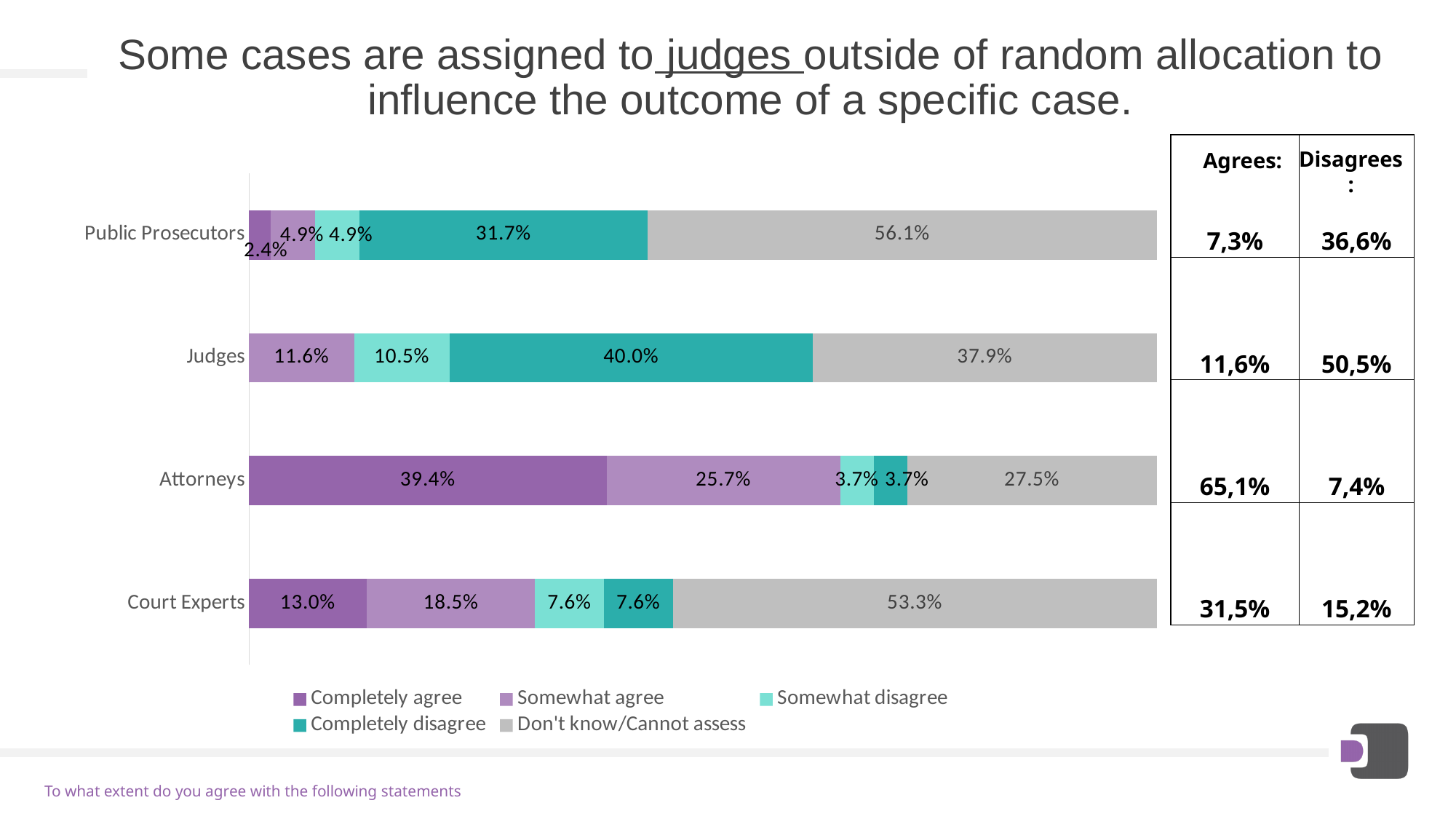
What percentage of Attorneys answered 'Completely agree'? 39.4% What percentage of Court Experts answered 'Somewhat agree'? 18.5% Which group has the lowest 'Don't know/Cannot assess' share? Attorneys Which is larger: the 'Somewhat agree' share for Attorneys or for Court Experts? Attorneys What percentage of Judges answered 'Completely disagree'? 40.0% What is the difference between the 'Completely disagree' shares of Judges and Public Prosecutors? 8.3% Which group has the highest 'Completely agree' share? Attorneys What percentage of Public Prosecutors answered 'Don't know/Cannot assess'? 56.1% How many groups (categories) are shown on the chart? 4 According to the table on the right, what is the 'Agrees' total for Attorneys? 65,1% What kind of chart is shown on the slide? Stacked bar chart How many series does the legend list? 5